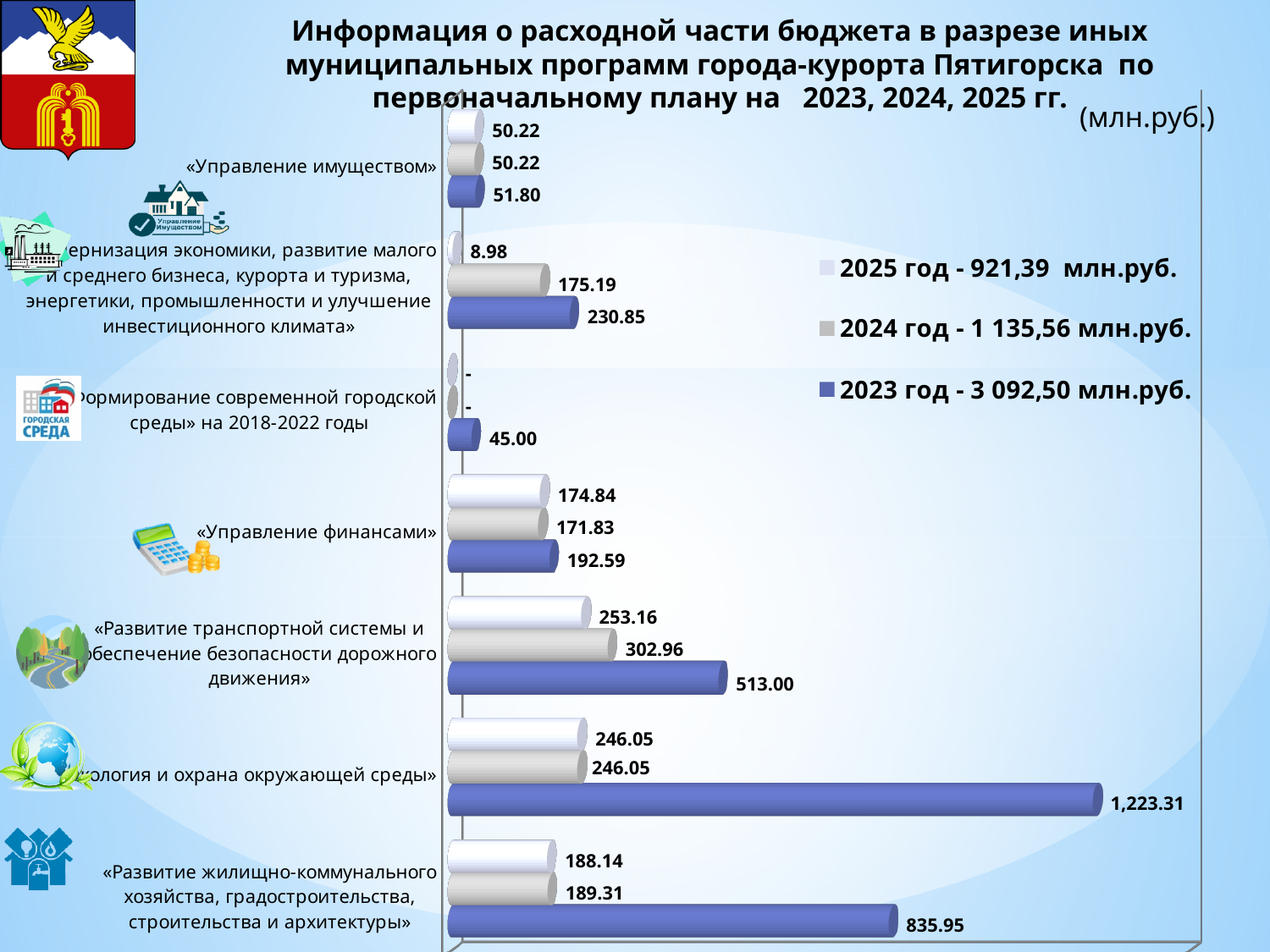
What is the 2023 value for «Формирование современной городской среды» на 2018-2022 годы? 45.00 What is the 2025 value for «Управление финансами»? 174.84 Which category has the lowest 2025 value among those with a printed number? «Модернизация экономики, развитие малого и среднего бизнеса, курорта и туризма, энергетики, промышленности и улучшение инвестиционного климата» According to the legend, what is the total for 2023 год? 3 092,50 млн.руб. What type of chart is shown on the slide? bar chart How many series does the legend list? 3 How many program categories are plotted on the chart? 7 What is the 2023 value for «Экология и охрана окружающей среды»? 1,223.31 What is the 2024 value for «Развитие транспортной системы и обеспечение безопасности дорожного движения»? 302.96 Which is larger for «Развитие транспортной системы и обеспечение безопасности дорожного движения»: the 2023 value or the 2025 value? 2023 value What is the difference between the 2023 and 2024 values for «Развитие жилищно-коммунального хозяйства, градостроительства, строительства и архитектуры»? 646.64 Which category has the highest 2023 value? «Экология и охрана окружающей среды»